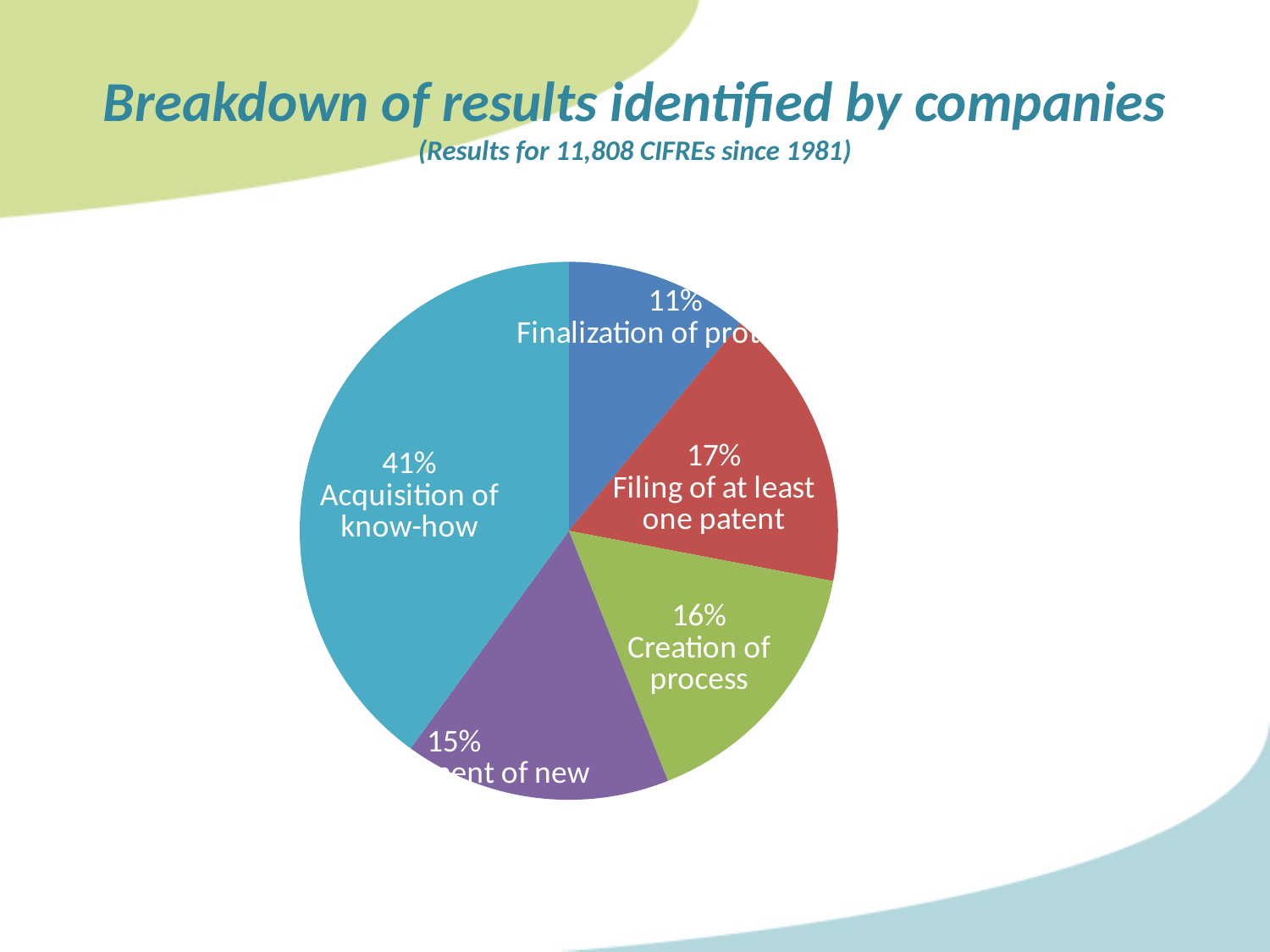
What is the smallest percentage shown on the pie chart? 11% Which is larger: Acquisition of know-how or Creation of process? Acquisition of know-how What percentage does the Filing of at least one patent slice represent? 17% Which is larger: Filing of at least one patent or Creation of process? Filing of at least one patent How many slices does the pie chart have? 5 What type of chart is shown on the slide? Pie chart What percentage of the pie chart is Acquisition of know-how? 41% Which category has the largest slice of the pie chart? Acquisition of know-how According to the subtitle, how many CIFREs do the results cover since 1981? 11,808 What is the difference in percentage points between Filing of at least one patent and Creation of process? 1 percentage point What is the difference in percentage points between Acquisition of know-how and Filing of at least one patent? 24 percentage points What percentage is shown for Creation of process? 16%